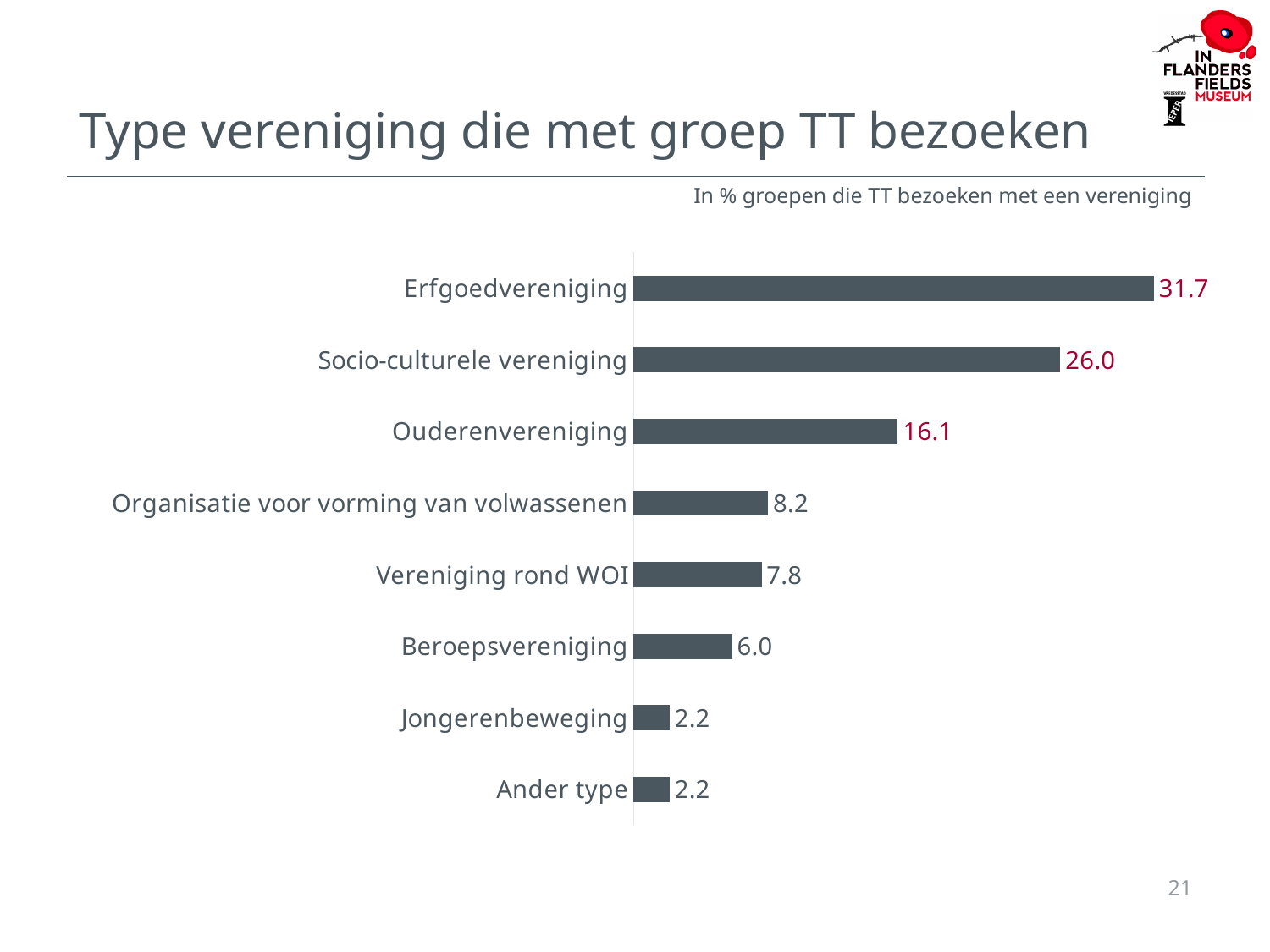
Which is larger, Socio-culturele vereniging or Ouderenvereniging? Socio-culturele vereniging What kind of chart is shown on the slide? Bar chart What is the difference between Erfgoedvereniging and Socio-culturele vereniging? 5.7 What is the title of the slide? Type vereniging die met groep TT bezoeken What is the value for Erfgoedvereniging? 31.7 What is the value for Beroepsvereniging? 6.0 Which category has the highest value? Erfgoedvereniging What is the value for Ouderenvereniging? 16.1 What is the value for Jongerenbeweging? 2.2 What is the difference between Ouderenvereniging and Organisatie voor vorming van volwassenen? 7.9 What is the value for Vereniging rond WOI? 7.8 How many categories are shown in the chart? 8